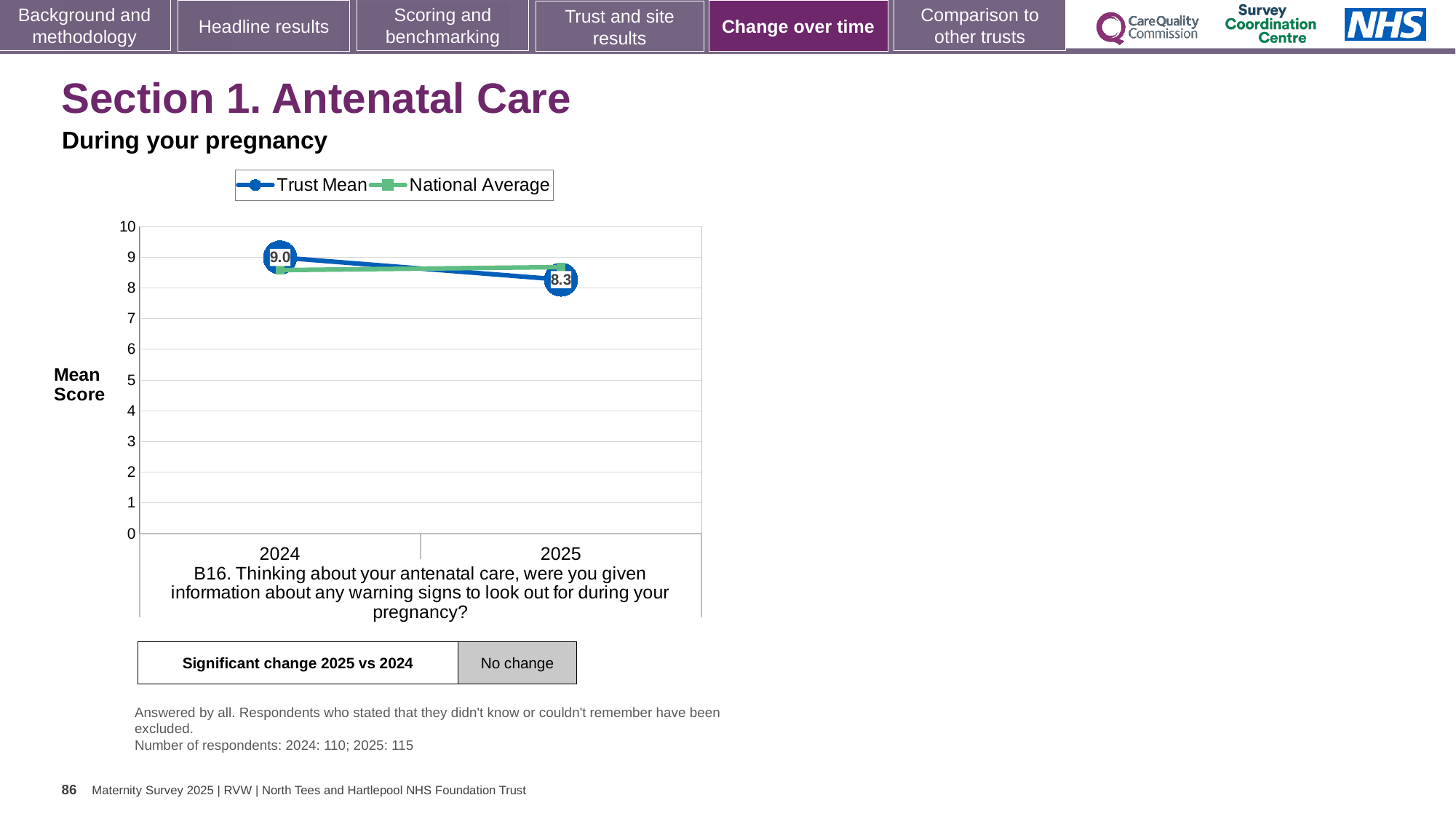
What is the label on the y axis of the chart? Mean Score How many years are plotted on the x axis? 2 What are the two series named in the legend? Trust Mean and National Average What kind of chart is shown on the slide? line chart What is the Trust Mean value for 2024? 9.0 What is the Trust Mean value for 2025? 8.3 Is the National Average value for 2024 greater or less than 8? greater Does the Trust Mean rise or fall from 2024 to 2025? fall How many series does the legend list? 2 Which year has the higher Trust Mean, 2024 or 2025? 2024 What is the difference between the Trust Mean in 2024 and the Trust Mean in 2025? 0.7 Is the National Average value for 2025 greater or less than 9? less